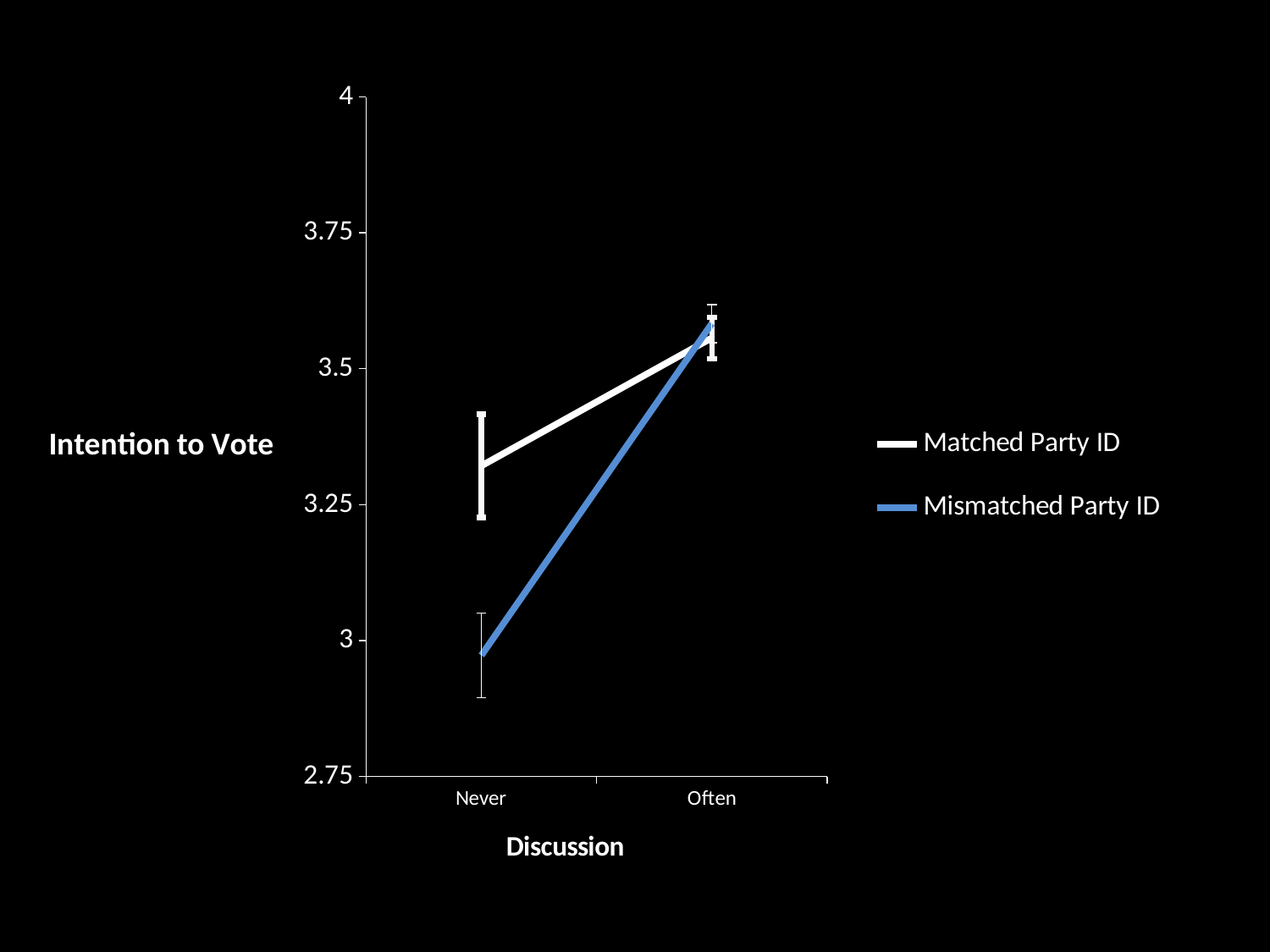
At Never, which series has the higher Intention to Vote: Matched Party ID or Mismatched Party ID? Matched Party ID Is the Matched Party ID value at Never greater or less than 3.25? greater Is the Mismatched Party ID value at Never greater or less than 3? less Is the Matched Party ID value at Often greater or less than 3.75? less Which series is drawn in blue? Mismatched Party ID How many series does the legend list? 2 Does the Mismatched Party ID line rise or fall from Never to Often? rise What is the title of the y axis? Intention to Vote How many categories are shown on the x axis? 2 Does the Matched Party ID line rise or fall from Never to Often? rise What kind of chart is shown on the slide? line chart